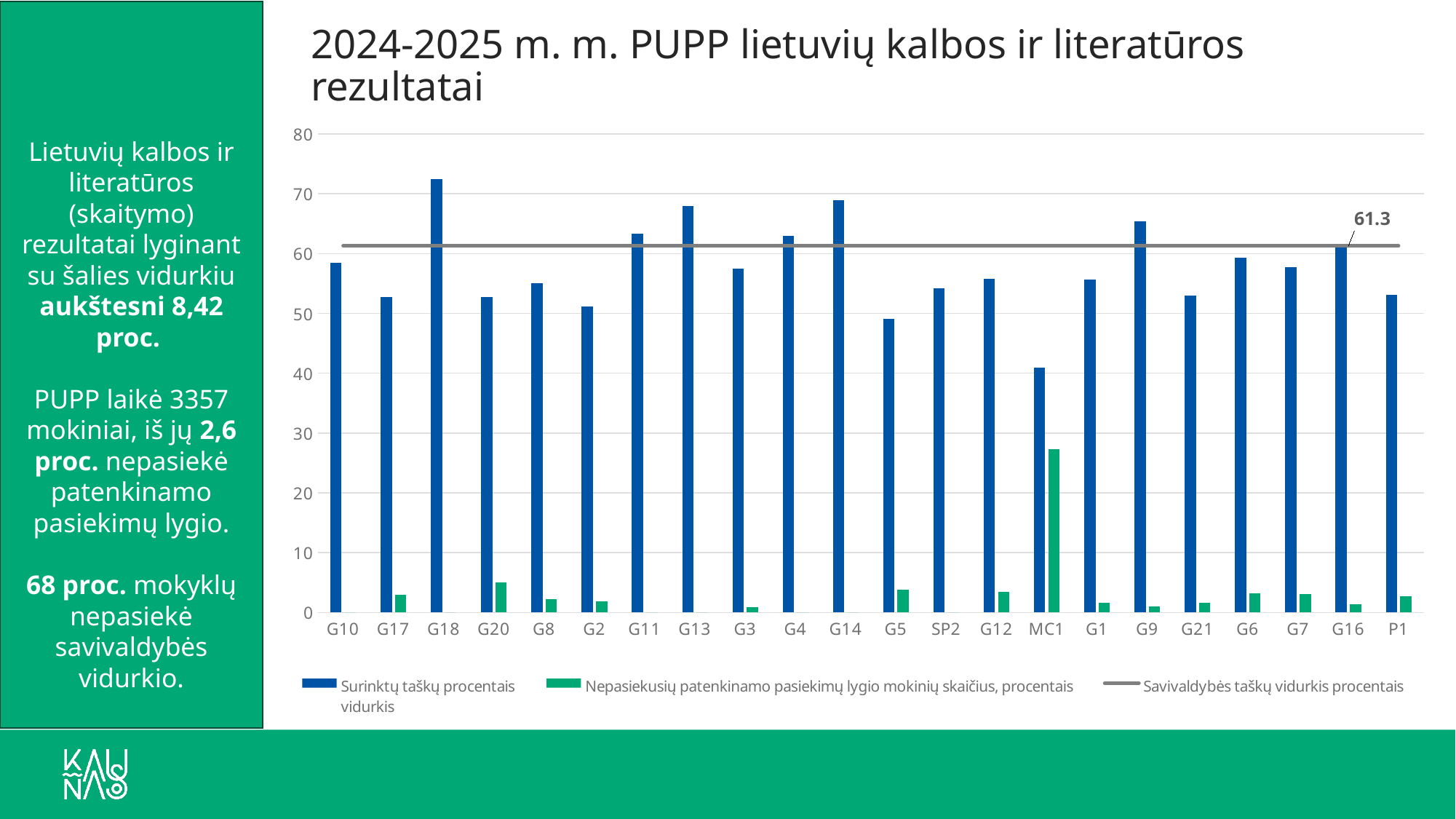
How many series does the legend list? 3 What kind of chart is shown on the slide? combination bar and line chart Which has the larger Surinktų taškų procentais vidurkis value, G18 or G13? G18 Is the Surinktų taškų procentais vidurkis value for MC1 greater or less than 50? less Which school has the highest value for Surinktų taškų procentais vidurkis? G18 What value is printed for the municipal average line (Savivaldybės taškų vidurkis procentais)? 61.3 How many school categories are shown on the x axis? 22 What is the title of the chart? 2024-2025 m. m. PUPP lietuvių kalbos ir literatūros rezultatai Is the Surinktų taškų procentais vidurkis value for G18 greater or less than 70? greater Which school has the lowest value for Surinktų taškų procentais vidurkis? MC1 Which school has the highest value for Nepasiekusių patenkinamo pasiekimų lygio mokinių skaičius, procentais? MC1 Is the Nepasiekusių patenkinamo pasiekimų lygio value for MC1 greater or less than 20? greater